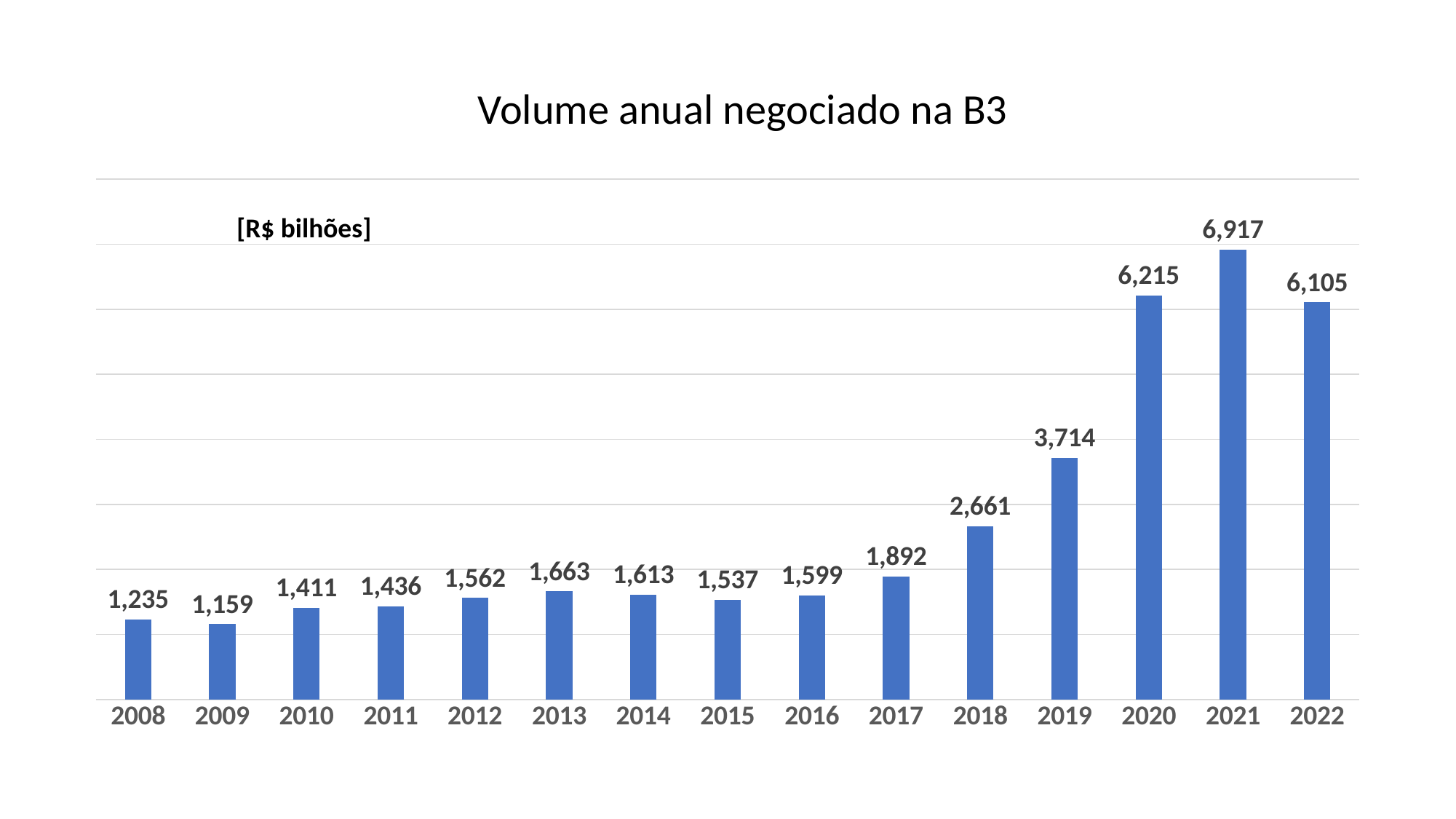
What is the difference between the values for 2021 and 2022? 812 Do the values generally rise or fall from 2016 to 2021? Rise What is the value for 2008? 1,235 How many years are shown on the x axis? 15 What is the title of the chart? Volume anual negociado na B3 Which year has the lowest value? 2009 What kind of chart is this? Bar chart What is the value for 2013? 1,663 Which is larger, the value for 2014 or the value for 2015? 2014 What is the value for 2020? 6,215 What is the difference between the values for 2019 and 2018? 1,053 Which year has the highest value? 2021